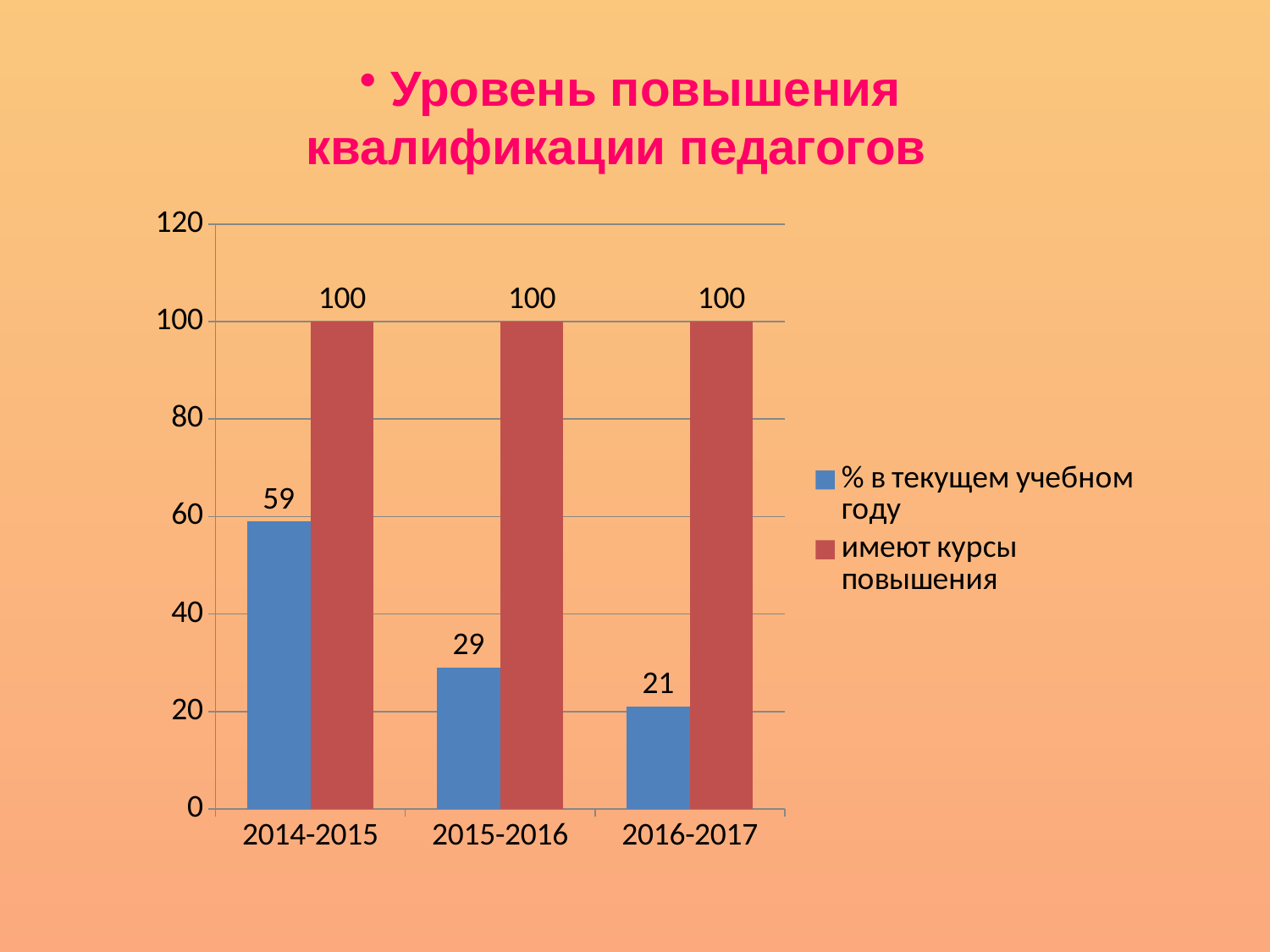
How many series does the legend list? 2 Which year has the highest value for "% в текущем учебном году"? 2014-2015 What is the value for "% в текущем учебном году" in 2015-2016? 29 What kind of chart is shown on the slide? Bar chart What is the value for "% в текущем учебном году" in 2016-2017? 21 What is the difference between the "% в текущем учебном году" values for 2014-2015 and 2016-2017? 38 Which is larger: the "% в текущем учебном году" value for 2015-2016 or for 2016-2017? 2015-2016 How many year categories are shown on the x axis? 3 Which year has the lowest value for "% в текущем учебном году"? 2016-2017 What is the value for "имеют курсы повышения" in 2015-2016? 100 What is the value for "% в текущем учебном году" in 2014-2015? 59 Does the "% в текущем учебном году" series rise or fall from 2014-2015 to 2016-2017? Fall